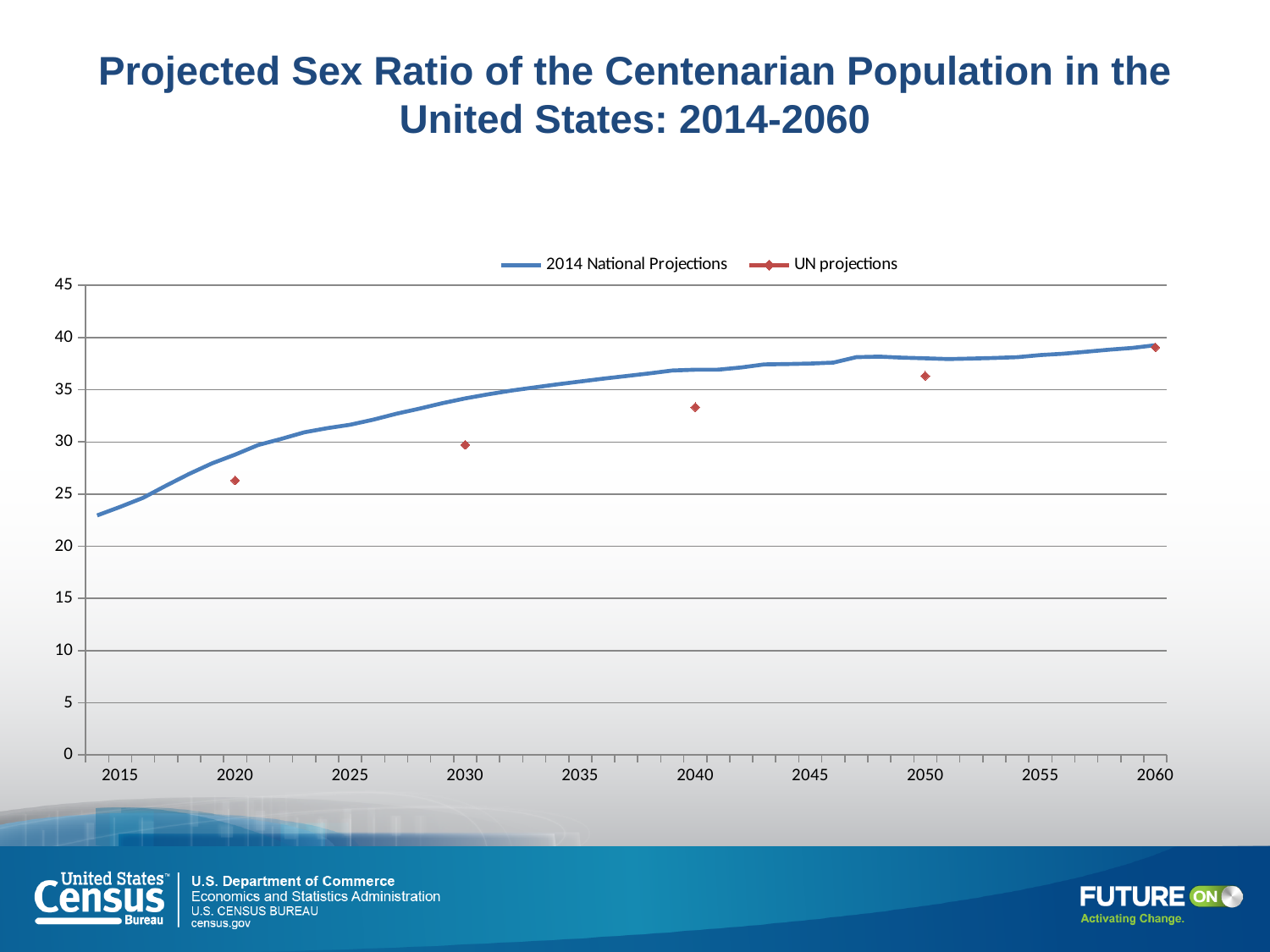
How many series does the legend list? 2 Is the UN projections value for 2050 greater or less than 35? greater What are the two series named in the legend? 2014 National Projections and UN projections Does the 2014 National Projections line rise or fall from 2015 to 2060? rise Is the UN projections value for 2020 greater or less than 30? less How many UN projections data points are plotted? 5 Is the 2014 National Projections value at 2015 greater or less than 25? less In 2040, which series has the higher value, 2014 National Projections or UN projections? 2014 National Projections What kind of chart is shown on the slide? line chart Which year has the lowest UN projections value? 2020